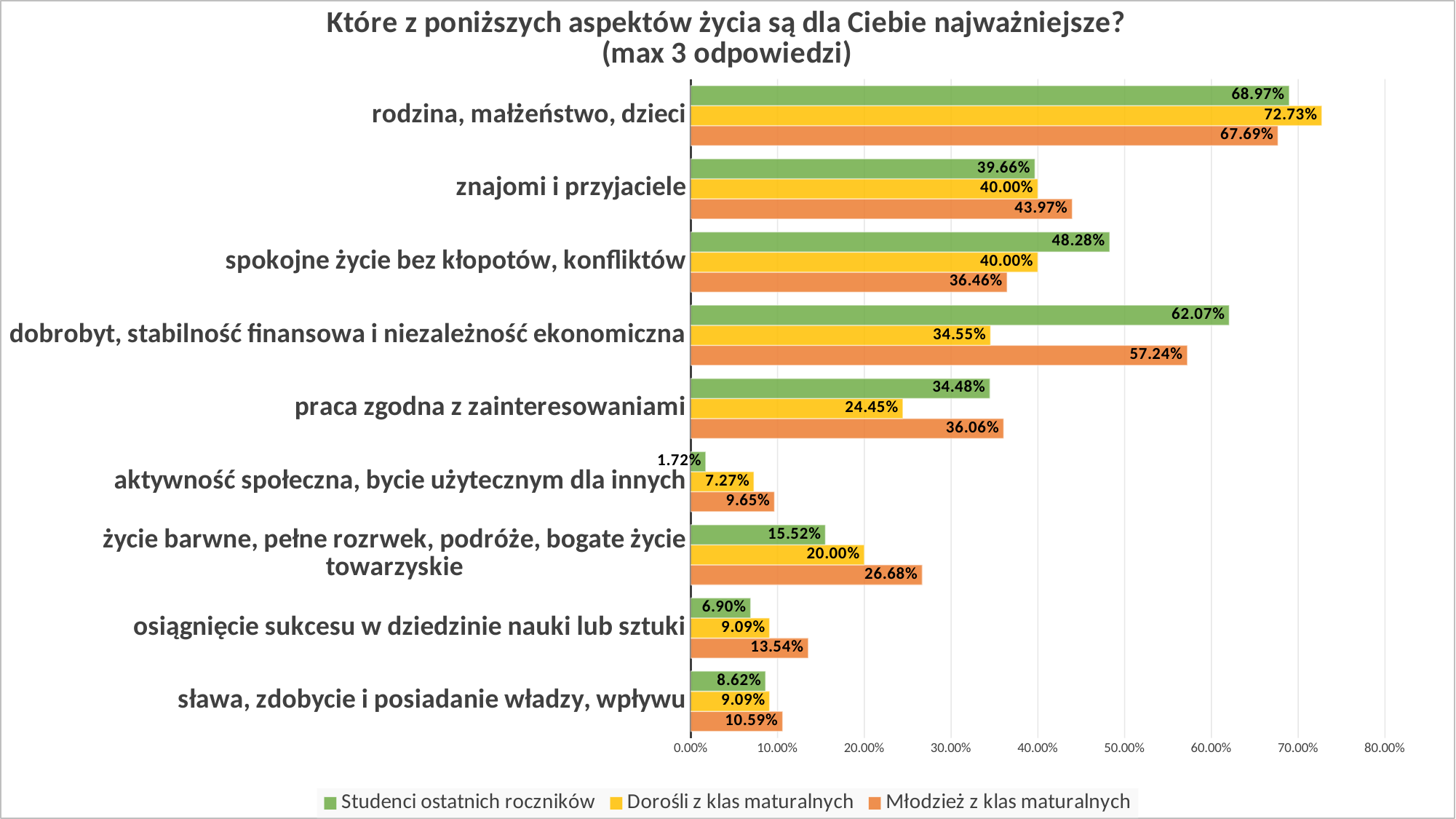
How many categories (aspects of life) are shown on the chart? 9 What type of chart is shown on the slide? bar chart Is the value for 'Młodzież z klas maturalnych' in the category 'praca zgodna z zainteresowaniami' greater or less than 30.00%? greater What is the difference between 'Studenci ostatnich roczników' and 'Dorośli z klas maturalnych' in the category 'dobrobyt, stabilność finansowa i niezależność ekonomiczna'? 27.52% How many series does the legend list? 3 Which category has the highest value for 'Młodzież z klas maturalnych'? rodzina, małżeństwo, dzieci Which colour represents the series 'Dorośli z klas maturalnych' in the legend? yellow What is the value for 'Dorośli z klas maturalnych' in the category 'rodzina, małżeństwo, dzieci'? 72.73% Which category has the lowest value for 'Studenci ostatnich roczników'? aktywność społeczna, bycie użytecznym dla innych What is the value for 'Młodzież z klas maturalnych' in the category 'życie barwne, pełne rozrywek, podróże, bogate życie towarzyskie'? 26.68% What is the value for 'Studenci ostatnich roczników' in the category 'dobrobyt, stabilność finansowa i niezależność ekonomiczna'? 62.07% In the category 'spokojne życie bez kłopotów, konfliktów', which series has the larger value: 'Studenci ostatnich roczników' or 'Młodzież z klas maturalnych'? Studenci ostatnich roczników